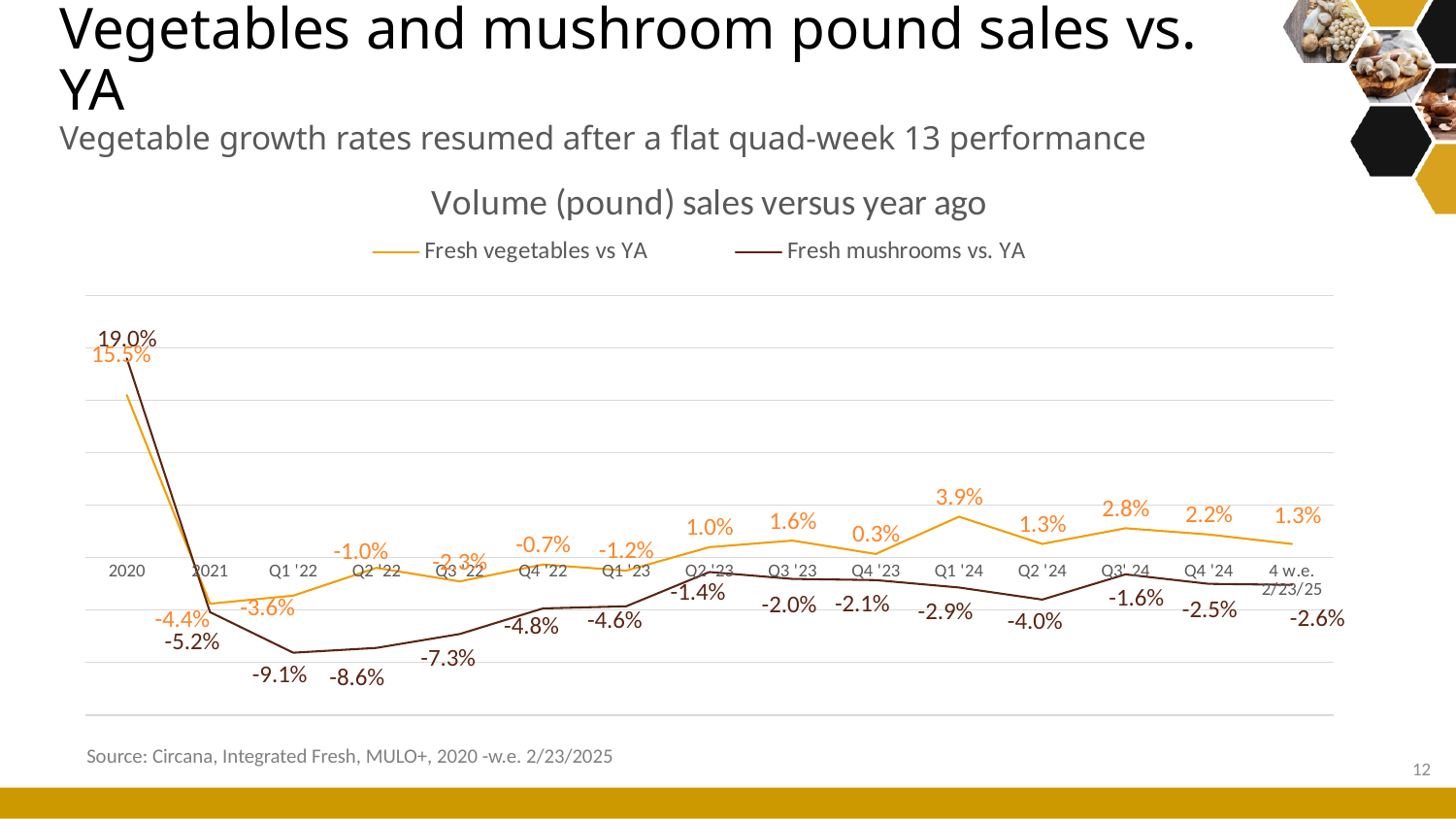
How many series does the legend list? 2 What is the value for Fresh vegetables vs YA in Q2 '24? 1.3% What is the value for Fresh mushrooms vs. YA for the 4 w.e. 2/23/25 period? -2.6% Which series is drawn in orange? Fresh vegetables vs YA How many time periods are plotted along the x axis? 15 In which period is the Fresh mushrooms vs. YA value lowest? Q1 '22 What kind of chart is shown on the slide? Line chart Which is larger for Fresh vegetables vs YA: the Q3 '24 value or the Q4 '24 value? Q3 '24 What is the value for Fresh vegetables vs YA in Q1 '24? 3.9% In which period is the Fresh vegetables vs YA value highest? 2020 In Q1 '24, what is the difference between the Fresh vegetables vs YA value and the Fresh mushrooms vs. YA value? 6.8 percentage points What is the value for Fresh mushrooms vs. YA in Q1 '22? -9.1%